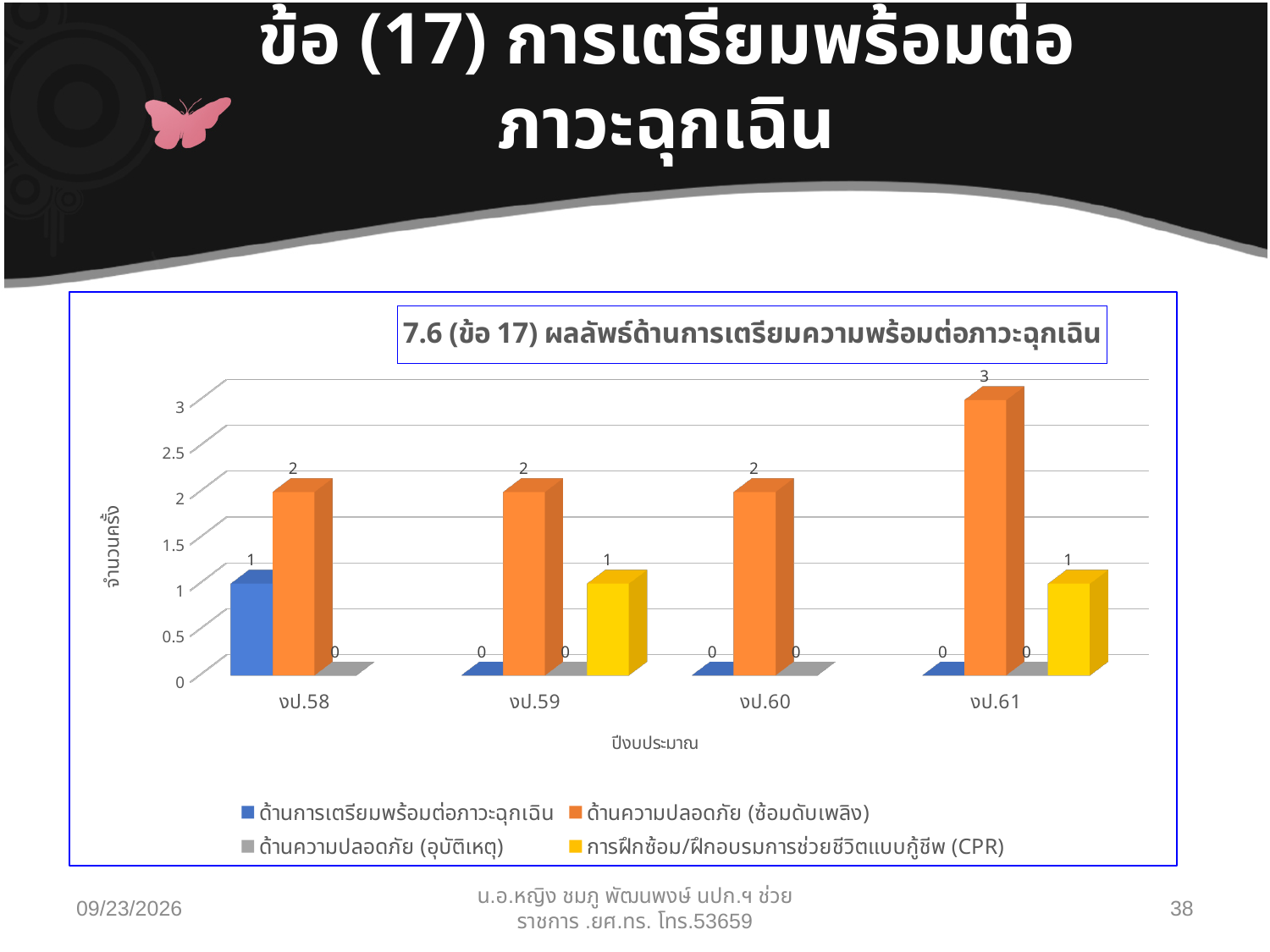
What is the difference between the ด้านความปลอดภัย (ซ้อมดับเพลิง) values for งป.61 and งป.60? 1 What is the label of the y axis? จำนวนครั้ง What is the value for ด้านการเตรียมพร้อมต่อภาวะฉุกเฉิน in งป.58? 1 What is the value for ด้านความปลอดภัย (ซ้อมดับเพลิง) in งป.61? 3 What is the value for การฝึกซ้อม/ฝึกอบรมการช่วยชีวิตแบบกู้ชีพ (CPR) in งป.59? 1 Which is larger in งป.58: ด้านการเตรียมพร้อมต่อภาวะฉุกเฉิน or ด้านความปลอดภัย (ซ้อมดับเพลิง)? ด้านความปลอดภัย (ซ้อมดับเพลิง) In which year is the value for ด้านความปลอดภัย (ซ้อมดับเพลิง) highest? งป.61 What is the value for ด้านความปลอดภัย (ซ้อมดับเพลิง) in งป.60? 2 How many years (categories) are shown on the x axis? 4 What kind of chart is shown on the slide? Bar chart What is the value for ด้านความปลอดภัย (อุบัติเหตุ) in งป.61? 0 How many series does the legend list? 4